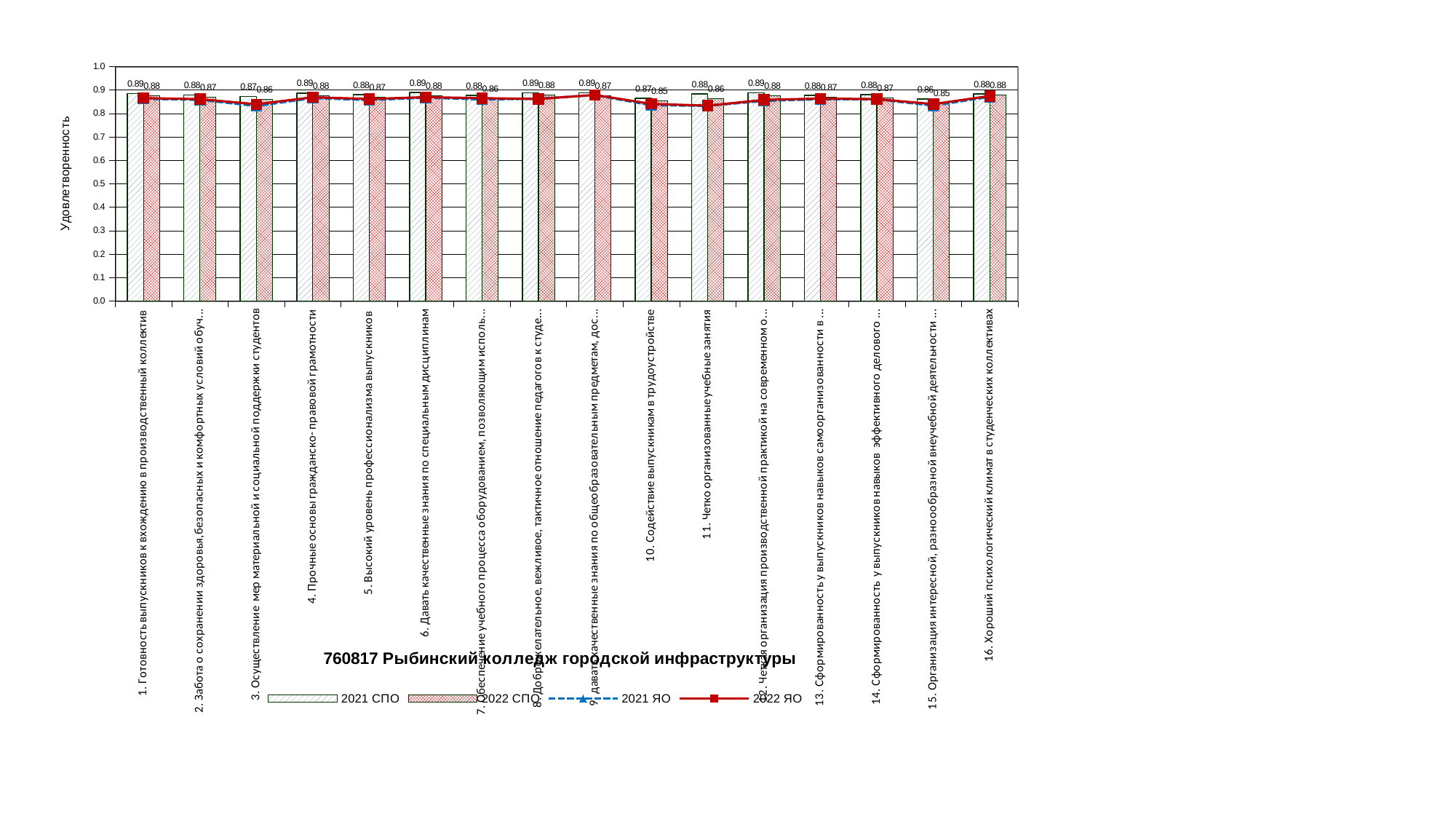
Which category has the lowest 2021 СПО value? Category 15 (Организация интересной, разнообразной внеучебной деятельности) For "1. Готовность выпускников к вхождению в производственный коллектив", which is larger: the 2021 СПО value or the 2022 СПО value? 2021 СПО What is the difference between the 2021 СПО and 2022 СПО values for "10. Содействие выпускникам в трудоустройстве"? 0.02 How many series does the legend list? 4 How many categories are plotted along the x axis? 16 What kind of chart is shown on the slide? A combined bar and line chart Is the 2021 СПО value for "4. Прочные основы гражданско-правовой грамотности" greater or less than 0.8? greater What is the 2022 СПО value for "3. Осуществление мер материальной и социальной поддержки студентов"? 0.86 What is the label of the vertical axis? Удовлетворенность What is the 2022 СПО value for "10. Содействие выпускникам в трудоустройстве"? 0.85 What is the 2021 СПО value for "16. Хороший психологический климат в студенческих коллективах"? 0.88 What is the title of the chart? 760817 Рыбинский колледж городской инфраструктуры